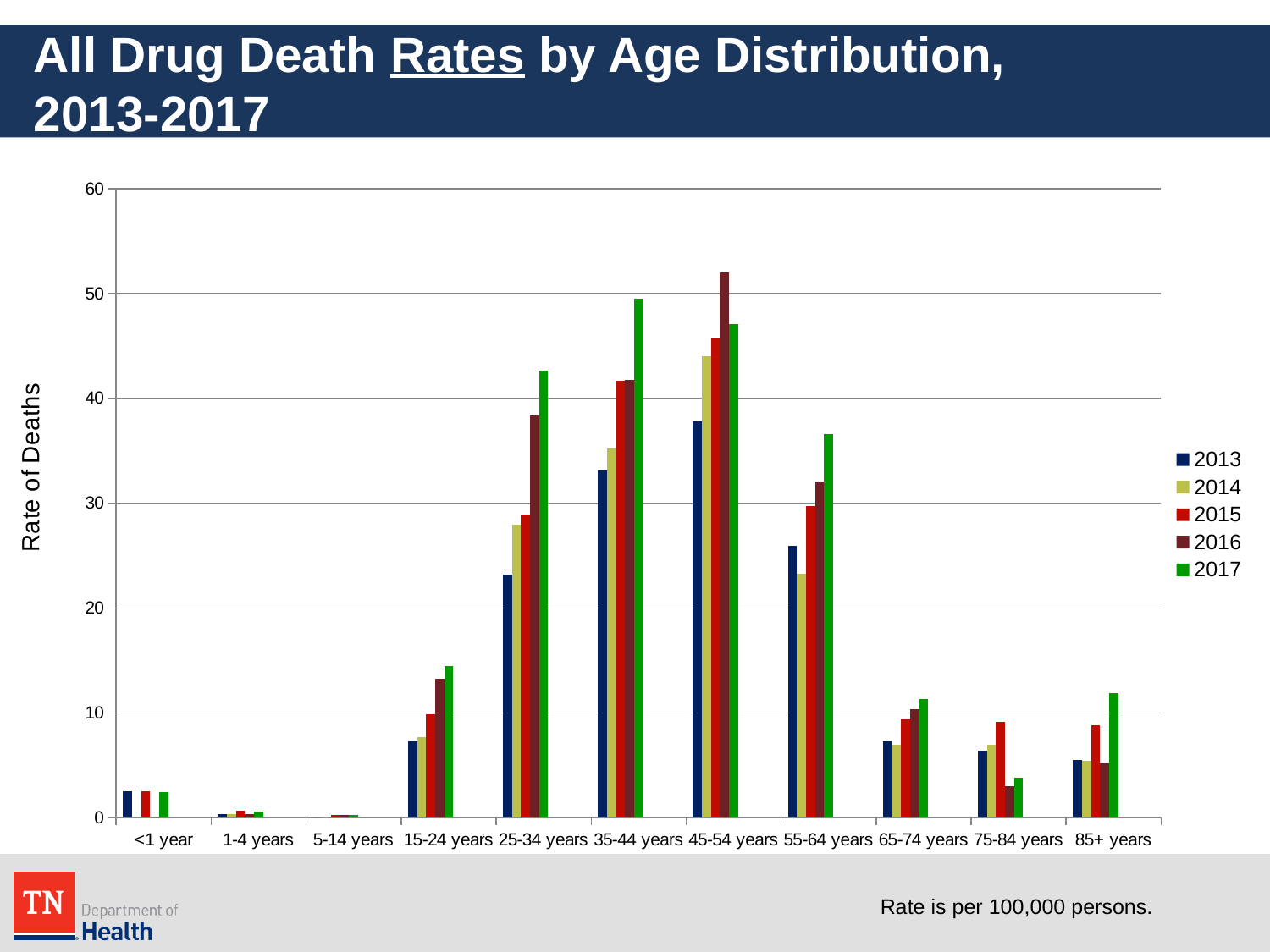
How many age groups are shown on the x axis? 11 Is the 2017 value for 35-44 years greater or less than 40? greater What is the label on the y axis? Rate of Deaths How many series does the legend list? 5 For the 55-64 years group, which is larger, the 2013 value or the 2017 value? 2017 Is the 2016 value for 75-84 years greater or less than 5? less What kind of chart is shown on the slide? bar chart Is the 2013 value for 25-34 years greater or less than 20? greater For the 45-54 years group, which is larger, the 2016 value or the 2017 value? 2016 Which year has the lowest rate for the 55-64 years group? 2014 For the 25-34 years group, do the values rise or fall from 2013 to 2017? rise Which age group has the highest rate for 2016? 45-54 years